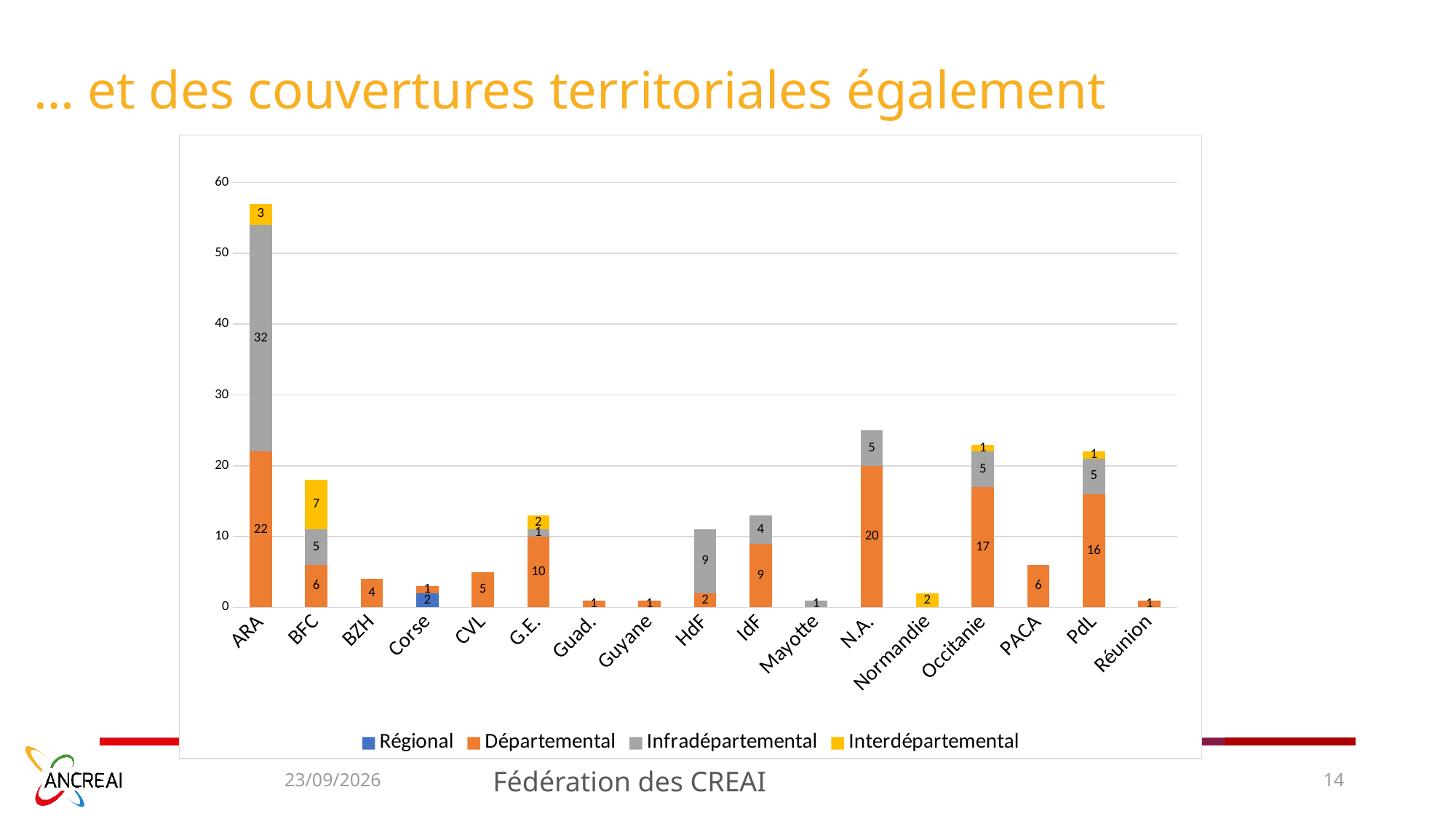
What is the Départemental value for N.A.? 20 What is the Régional value for Corse? 2 Which region has the highest total stacked bar? ARA What type of chart is shown on the slide? Stacked bar chart What is the total of the stacked bar for ARA? 57 What is the Interdépartemental value for BFC? 7 What is the total of the stacked bar for Occitanie? 23 What is the difference between the Départemental values for Occitanie and PdL? 1 What is the Infradépartemental value for ARA? 32 Which is larger, the Départemental value for IdF or the Départemental value for G.E.? G.E. How many series does the legend list? 4 How many regions (categories) are shown on the x axis? 17